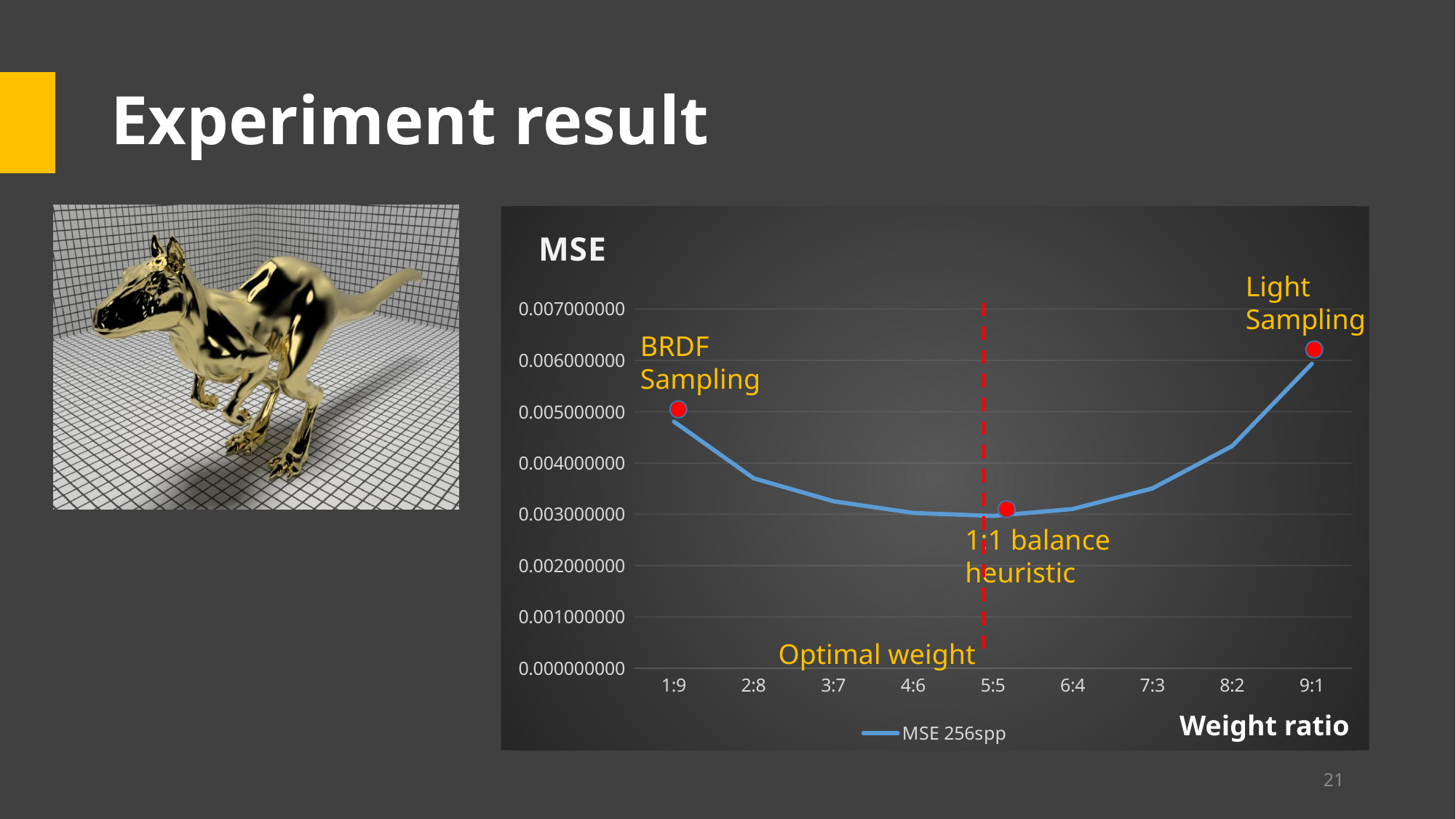
How many series does the legend list? 1 How many weight ratio categories are plotted along the x axis? 9 What is the name of the series shown in the legend? MSE 256spp Is the MSE value for weight ratio 1:9 greater or less than 0.004000000? greater Is the MSE value for weight ratio 2:8 greater or less than 0.004000000? less Is the MSE value for weight ratio 9:1 greater or less than 0.005000000? greater Which has a larger MSE, weight ratio 1:9 or weight ratio 9:1? 9:1 Which weight ratio has the highest MSE? 9:1 Which has a larger MSE, weight ratio 2:8 or weight ratio 8:2? 8:2 Does the MSE rise or fall as the weight ratio goes from 1:9 to 5:5? fall What kind of chart is shown on the slide? line chart